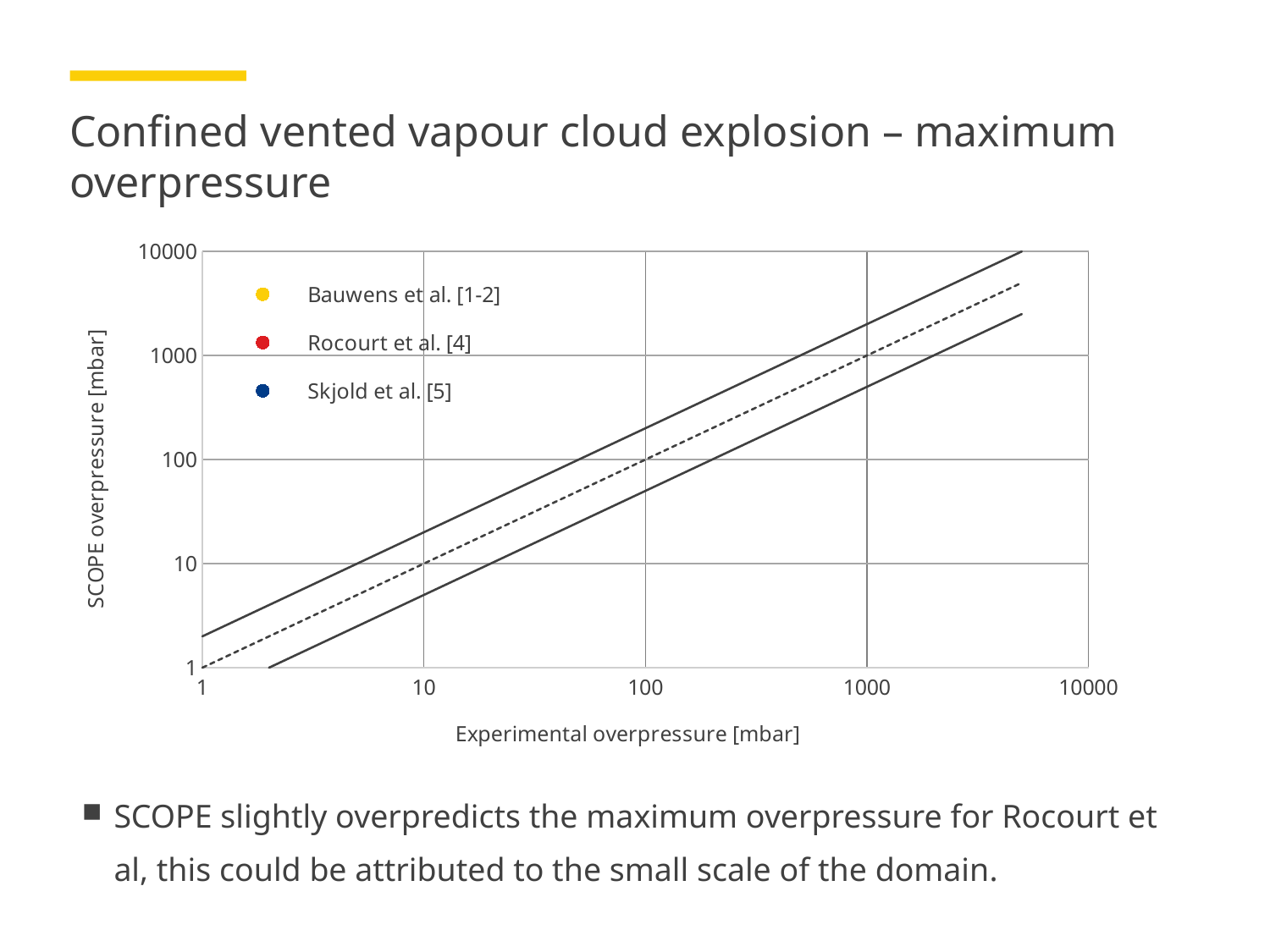
Which legend entry is shown with a red marker? Rocourt et al. [4] How many series does the chart legend list? 3 What is the label of the chart's y axis? SCOPE overpressure [mbar] Do the reference lines on the chart rise or fall as the experimental overpressure increases along the x axis? rise What kind of chart is shown on the slide? scatter chart